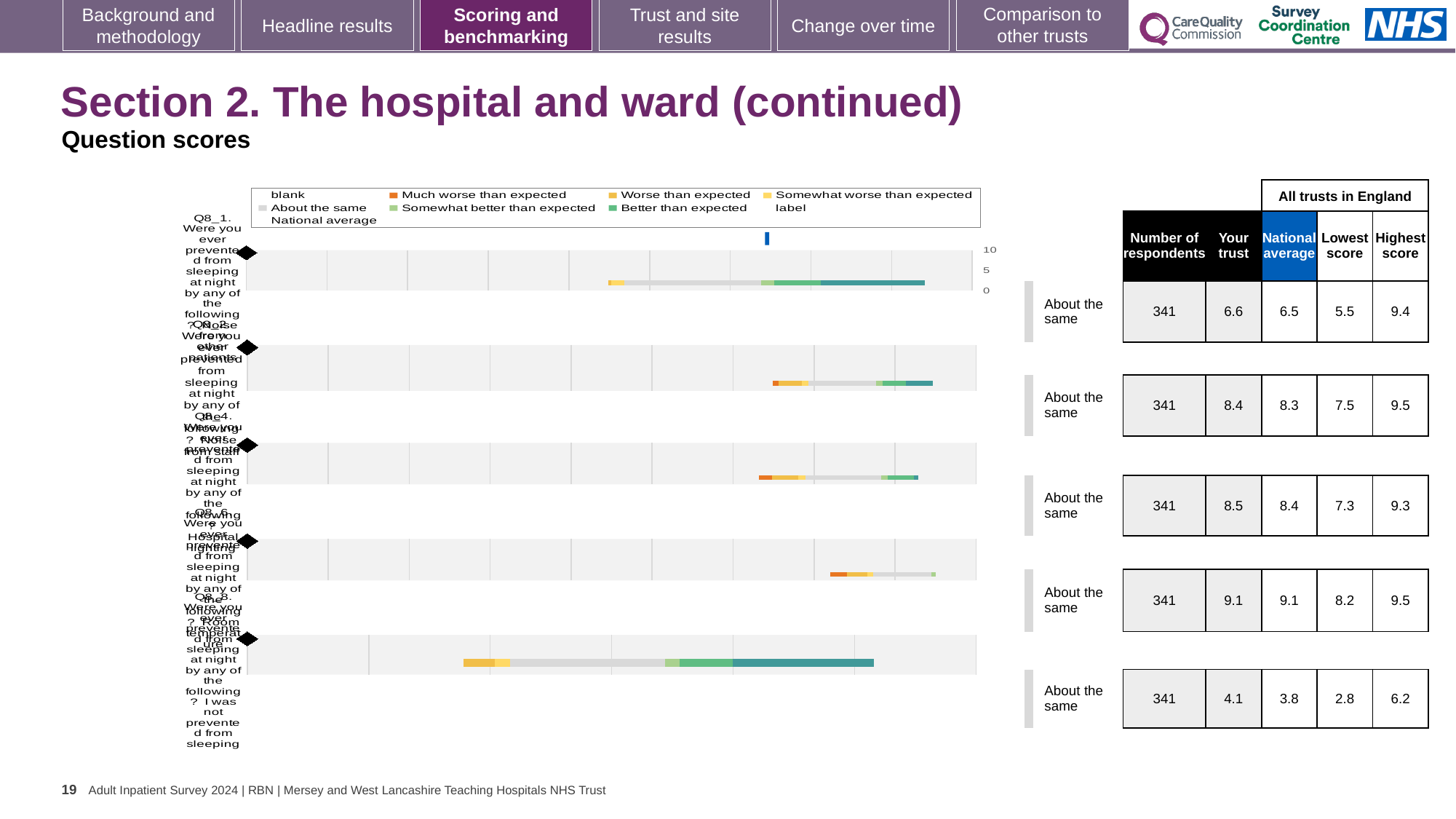
In the table beside the charts, what is the 'National average' for the last row (Q8_8)? 3.8 In the table beside the charts, what benchmark label is given for every question row? About the same What colour does the legend use for 'Much worse than expected'? orange What colour does the legend use for 'Better than expected'? teal In the table beside the charts, what is the difference between the highest score and the lowest score for the first row (Q8_1)? 3.9 What kind of chart is used for the question scores on this slide? bar chart In the table beside the charts, what is the number of respondents shown for each question? 341 In the table beside the charts, what is the 'Your trust' score for the first row (Q8_1)? 6.6 In the table beside the charts, which row has the highest 'Your trust' score? the fourth row (Q8_6), 9.1 How many separate bar charts are shown on the slide? 5 In the table beside the charts, which row has the lowest 'Your trust' score? the last row (Q8_8), 4.1 In the table beside the charts, for the first row (Q8_1), is the 'Your trust' score or the 'National average' larger? Your trust